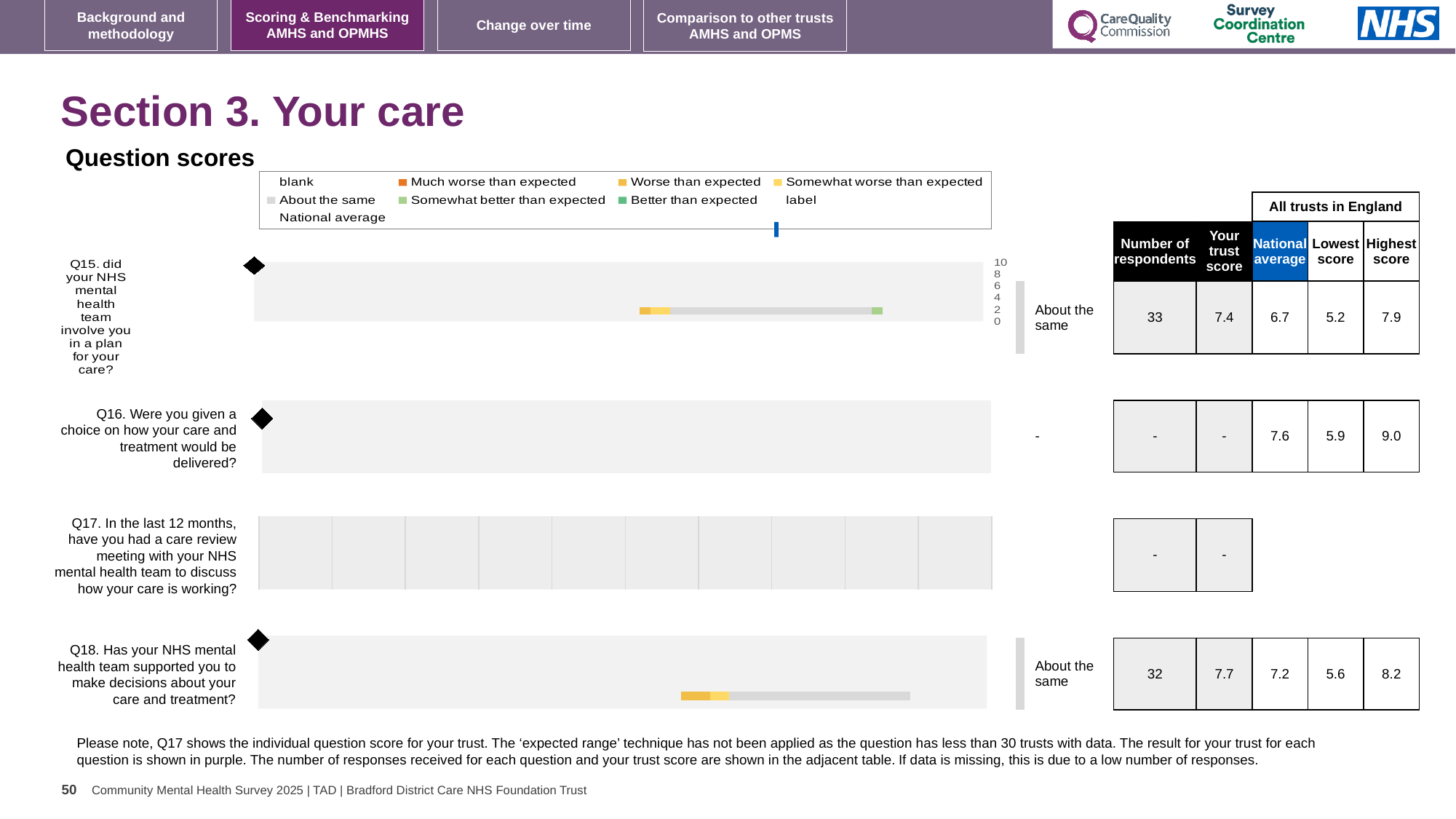
What is the difference between the trust score and the national average for Q18? 0.5 What is the trust score for Q15 (did your NHS mental health team involve you in a plan for your care)? 7.4 How many entries does the legend of the Question scores chart list? 9 What is the highest score across all trusts in England for Q16? 9.0 What is the national average for Q18 (has your NHS mental health team supported you to make decisions about your care and treatment)? 7.2 Which question has the lowest 'Lowest score' value among all trusts in England? Q15 Which question has the highest 'Highest score' value among all trusts in England? Q16 How many questions (Q15 to Q18) are plotted in the Question scores chart? 4 Which is larger for Q15, the trust score or the national average? trust score How many respondents answered Q15? 33 What benchmark label is shown next to the bar for Q18? About the same What kind of chart is used to show the question scores on this slide? bar chart